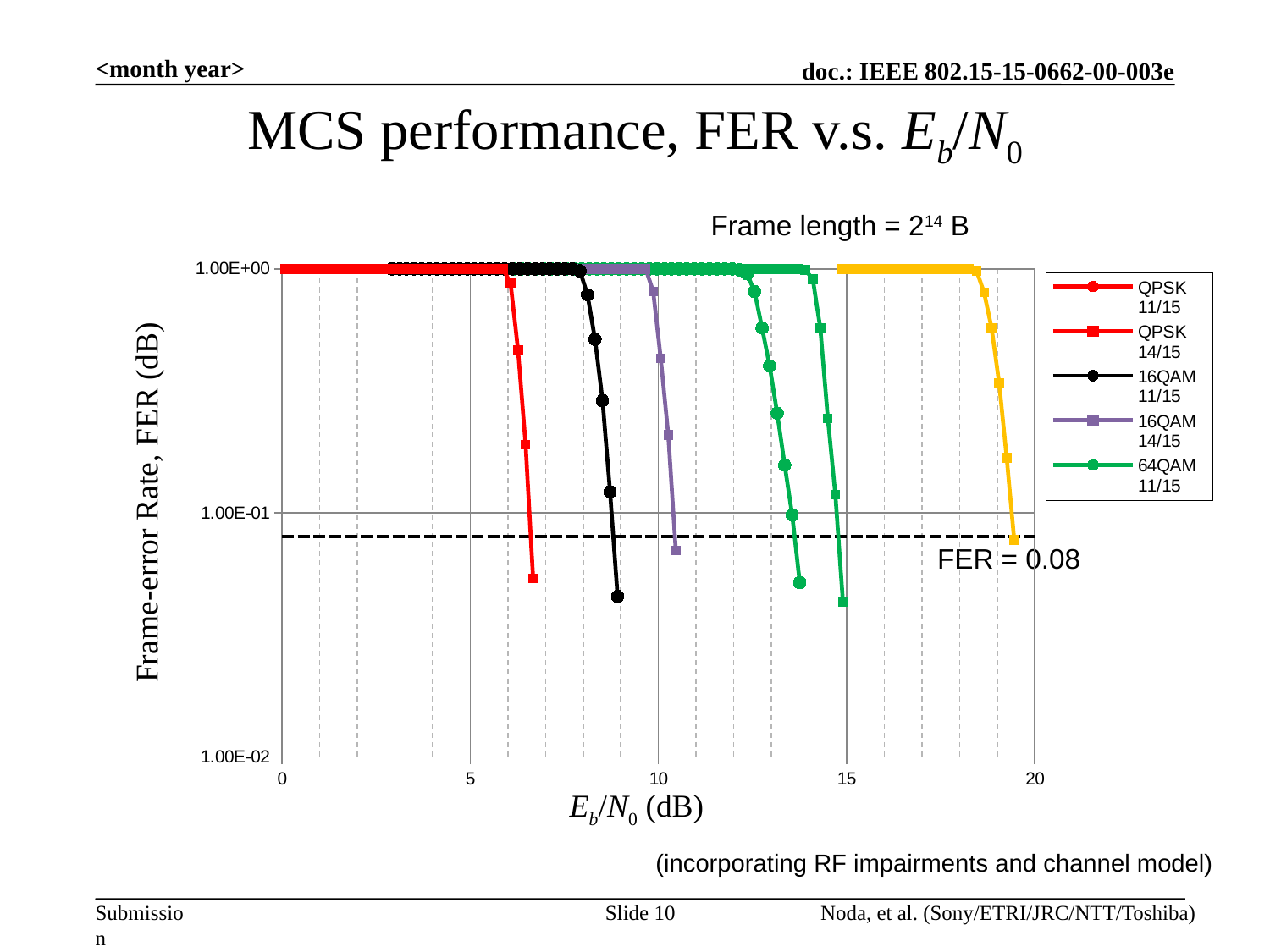
What is the title of the chart on the slide? MCS performance, FER v.s. Eb/N0 What is the maximum value shown on the x axis of the chart? 20 What is the lowest value shown on the y axis of the chart? 1.00E-02 What FER value does the horizontal dashed line on the chart mark? 0.08 As Eb/N0 increases along the x axis, does the frame-error rate of each curve rise or fall? Fall How many series does the chart's legend list? 5 Does the 64QAM 11/15 curve reach FER = 0.08 at a higher or lower Eb/N0 than the 16QAM 11/15 curve? Higher What kind of chart is shown on the slide? Line chart Is the lowest plotted point of the 16QAM 11/15 curve greater or less than 1.00E-01? less What is the label of the x axis of the chart? Eb/N0 (dB) Which series in the legend is drawn in purple? 16QAM 14/15 What frame length is stated above the chart? 2^14 B